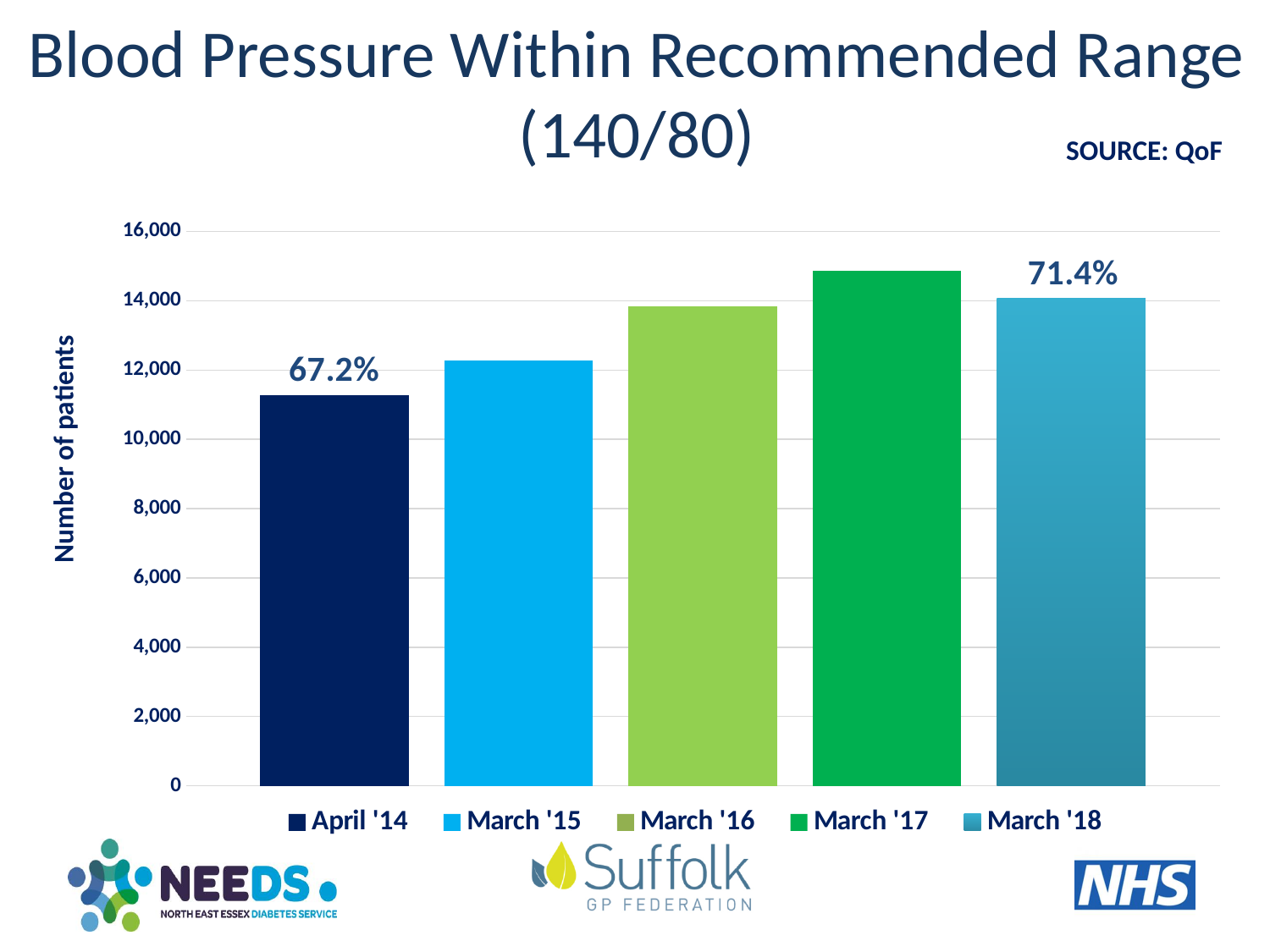
What is the label on the vertical axis? Number of patients Which period has the highest number of patients? March '17 How many bars are plotted in the chart? 5 Which is larger, the value for March '17 or the value for March '18? March '17 What kind of chart is shown on the slide? bar chart Is the value for March '17 greater or less than 14,000? greater What percentage label is printed above the March '18 bar? 71.4% Is the value for April '14 greater or less than 12,000? less Do the values rise or fall from April '14 to March '17? rise What percentage label is printed above the April '14 bar? 67.2% Which period has the lowest number of patients? April '14 How many entries does the legend list? 5